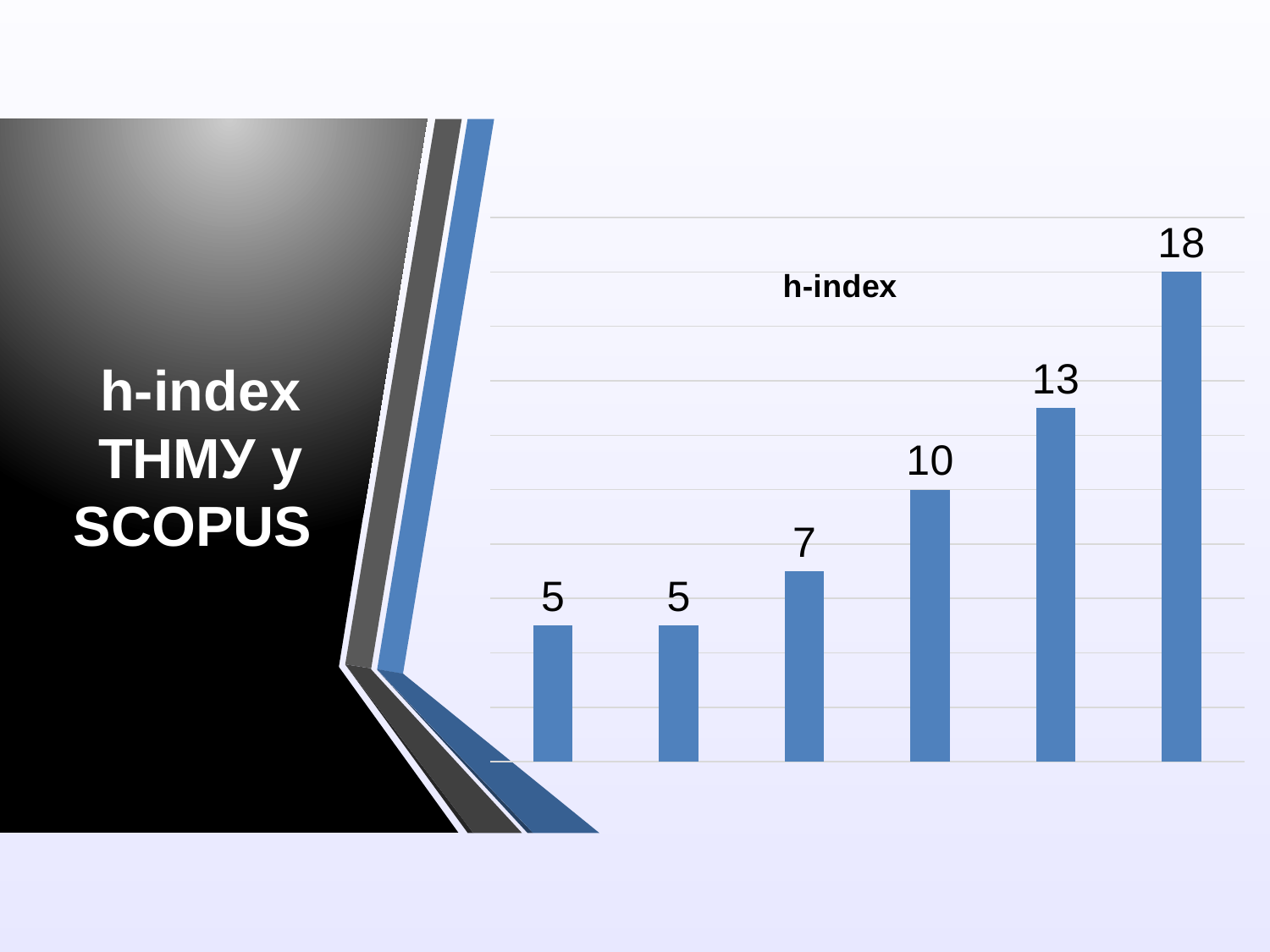
What type of chart is shown on the slide? bar chart What is the difference between the rightmost bar and the leftmost bar? 13 What is the value of the leftmost bar in the chart? 5 What is the lowest value shown in the chart? 5 Do the values rise or fall from left to right across the chart? rise What is the value of the third bar from the left? 7 Which is larger, the fifth bar from the left or the fourth bar from the left? the fifth bar (13) What is the value of the rightmost bar in the chart? 18 What is the value of the fourth bar from the left? 10 What is the highest value shown in the chart? 18 What is the title of the chart? h-index How many bars are plotted in the chart? 6